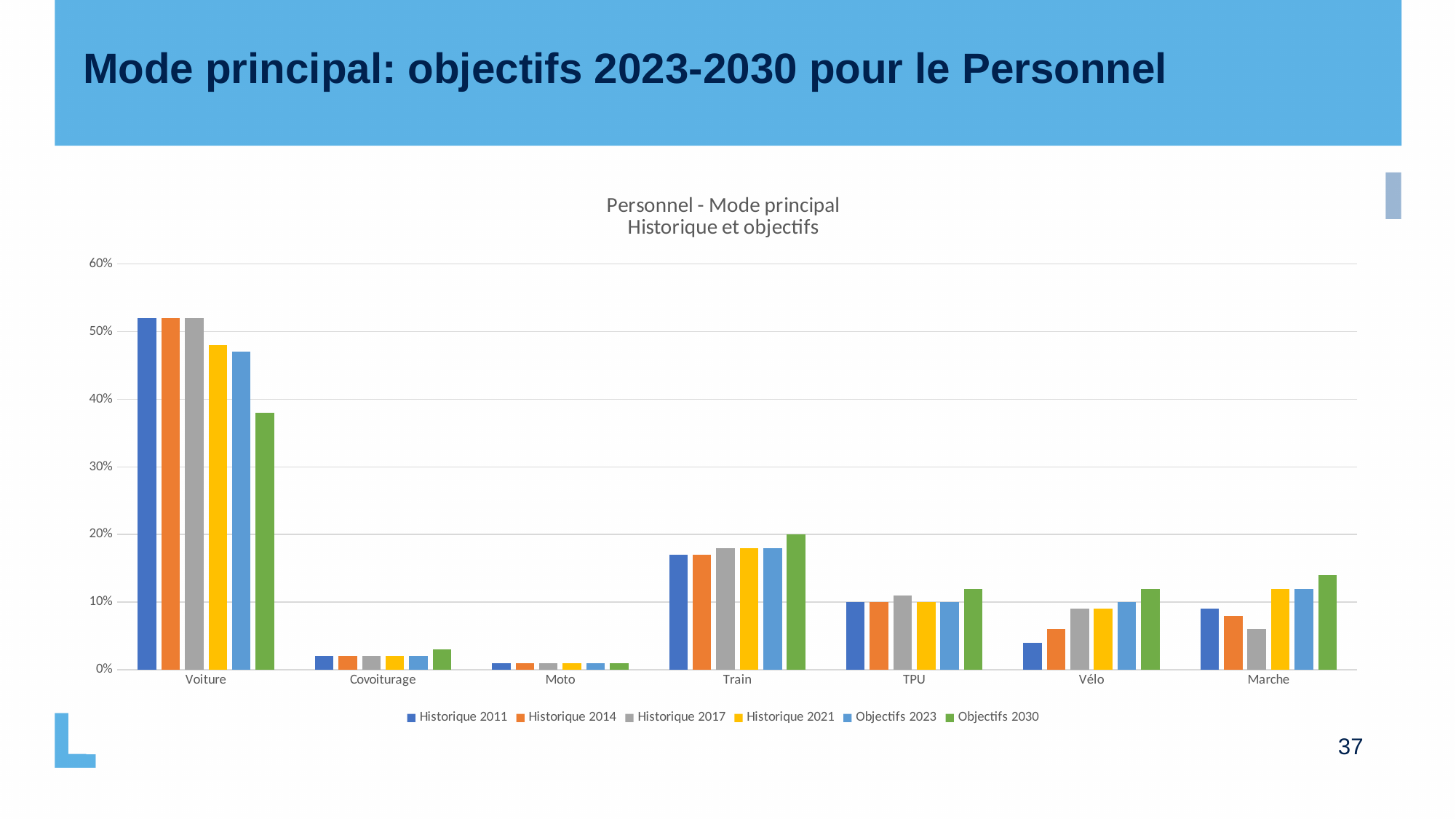
Do the Voiture values rise or fall from Historique 2011 to Objectifs 2030? fall How many transport mode categories are shown on the x axis? 7 How many series does the legend list? 6 What kind of chart is shown on the slide? bar chart Is the value for Marche in Objectifs 2030 greater or less than 10%? greater For Historique 2011, which is larger: Vélo or Marche? Marche Which category has the lowest value for Objectifs 2030? Moto For Voiture, which is larger: Historique 2021 or Objectifs 2030? Historique 2021 What is the title of the chart? Personnel - Mode principal Historique et objectifs Is the value for Voiture in Objectifs 2030 greater or less than 40%? less Which category has the highest value for Objectifs 2030? Voiture Is the value for Voiture in Historique 2011 greater or less than 50%? greater